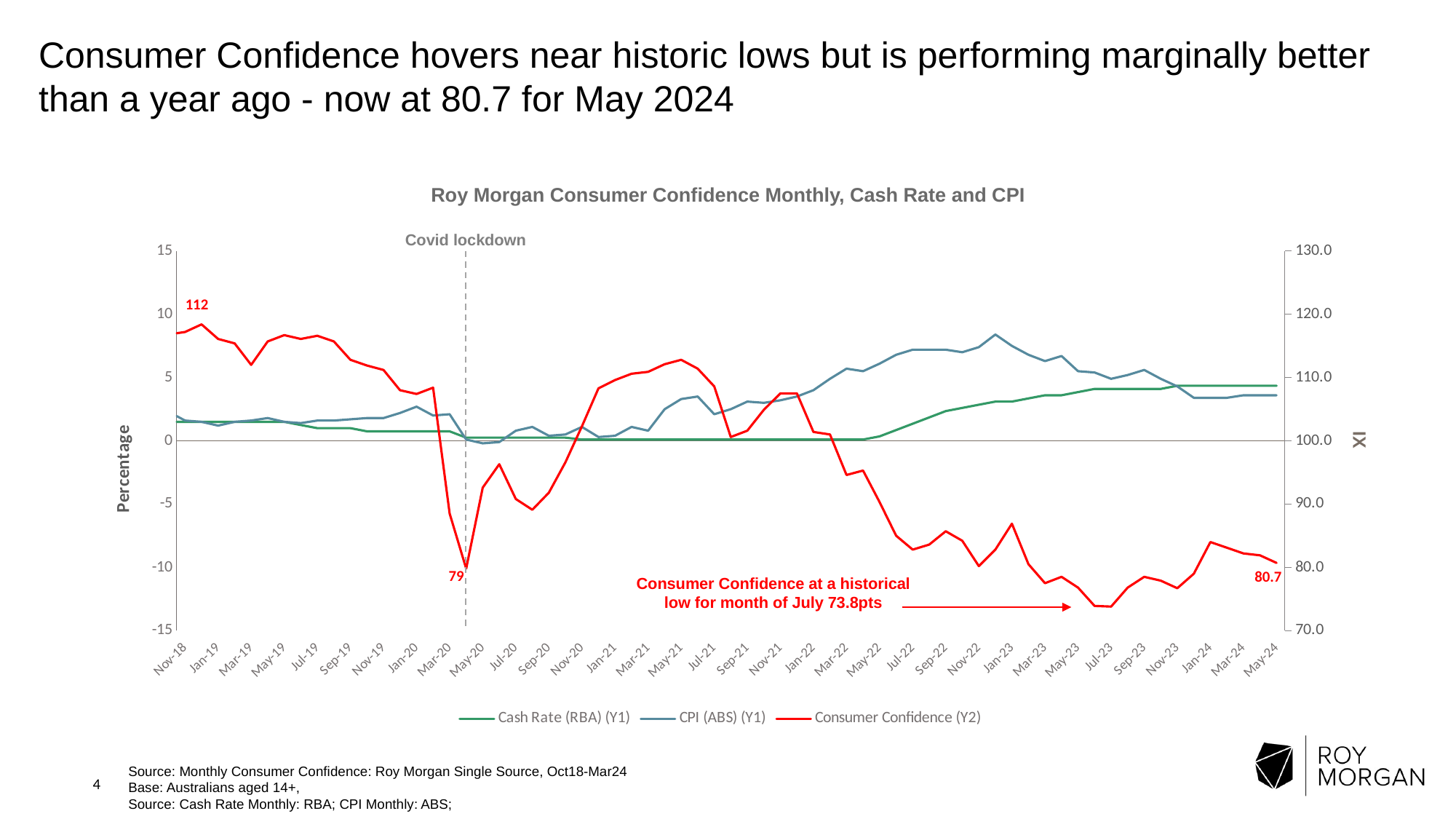
How many series does the legend list? 3 What is the difference between the labelled Consumer Confidence values 112 and 79? 33 Which is higher: Consumer Confidence at Nov-18 or at May-24? Nov-18 What kind of chart is shown on the slide? line chart What is the difference between the Consumer Confidence value for May-24 (80.7) and the historical July low (73.8)? 6.9 According to the annotation, what was the historical low Consumer Confidence value for the month of July? 73.8pts What event does the dashed vertical line on the chart mark? Covid lockdown Is the Cash Rate (RBA) value for May-24 greater or less than 5? less What Consumer Confidence value is labelled at the start of the series (Nov-18)? 112 What is the Consumer Confidence value for May-24? 80.7 What Consumer Confidence value is labelled at the Covid lockdown low? 79 Is the CPI (ABS) value for Jan-23 greater or less than 5? greater